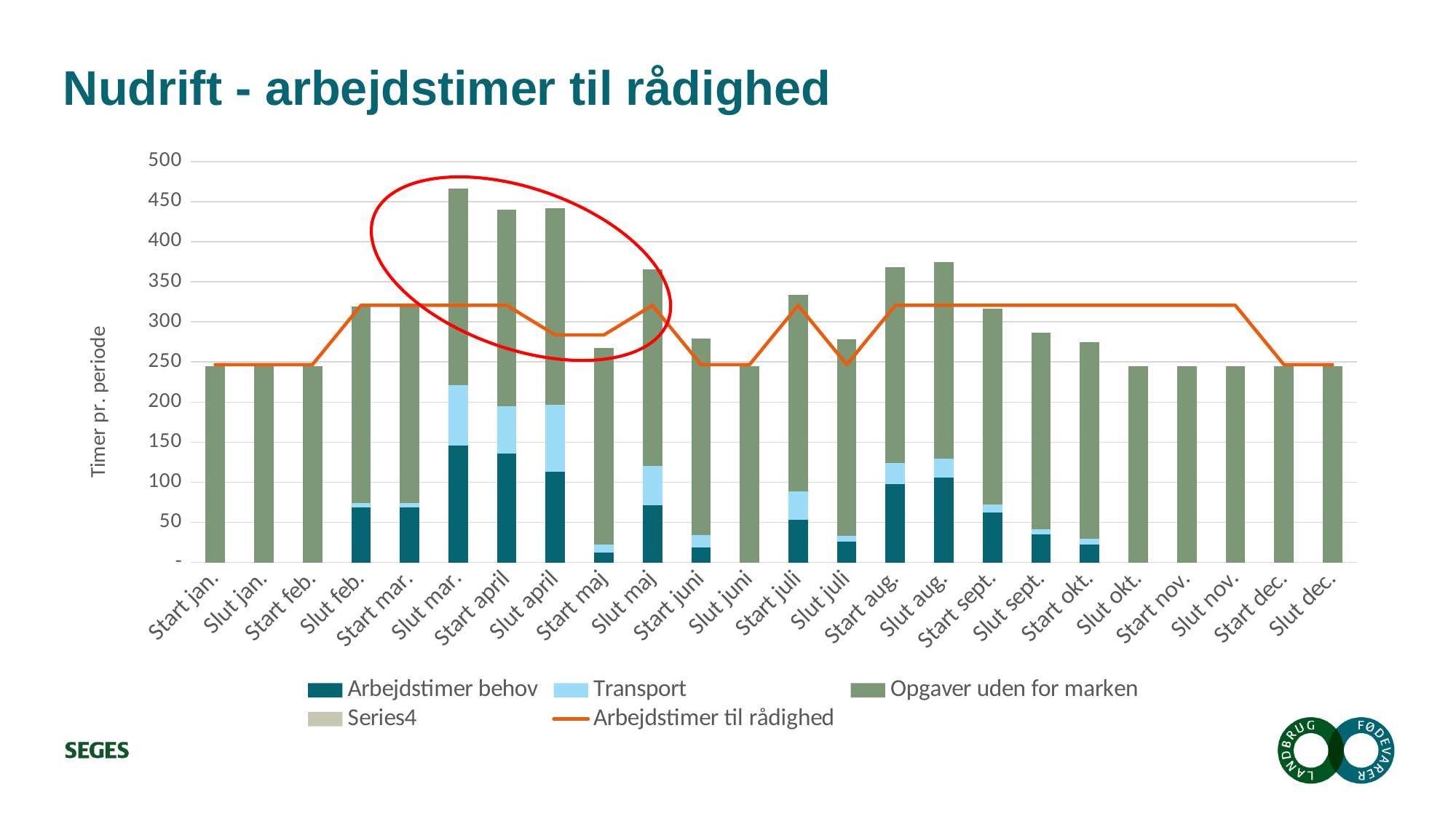
What is the label on the y axis? Timer pr. periode What is the title of the chart? Nudrift - arbejdstimer til rådighed Do the stacked bar totals rise or fall from Slut mar. to Start maj? fall Is the Arbejdstimer til rådighed line value at Slut feb. greater or less than 300? greater Is the total bar height for Slut mar. greater or less than 450? greater Which has the taller stacked bar, Slut mar. or Start april? Slut mar. How many series does the legend list? 5 How many periods (categories) are shown along the x axis? 24 Is the total bar height for Slut maj greater or less than 350? greater What kind of chart is shown on the slide? Stacked bar chart with a line Which period has the tallest stacked bar? Slut mar.